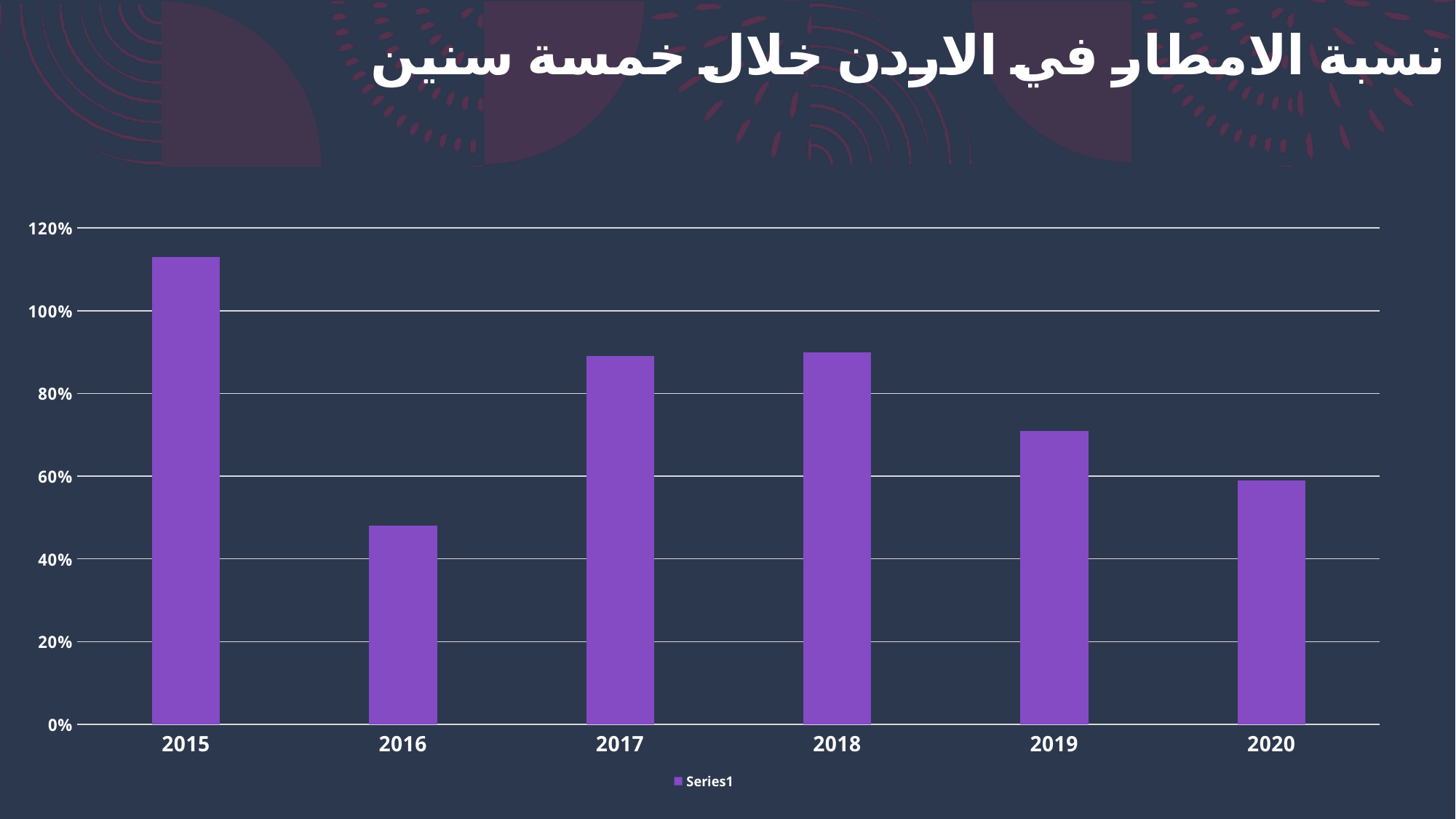
Is the value for 2016 greater or less than 60%? less How many years are shown on the x axis of the chart? 6 Is the value for 2015 greater or less than 100%? greater Is the value for 2017 greater or less than 80%? greater What kind of chart is shown on the slide? bar chart Which is larger, the value for 2019 or the value for 2020? 2019 How many series does the legend list? 1 Which is larger, the value for 2016 or the value for 2018? 2018 What is the name of the series shown in the legend? Series1 Which year has the lowest bar? 2016 Which year has the highest bar? 2015